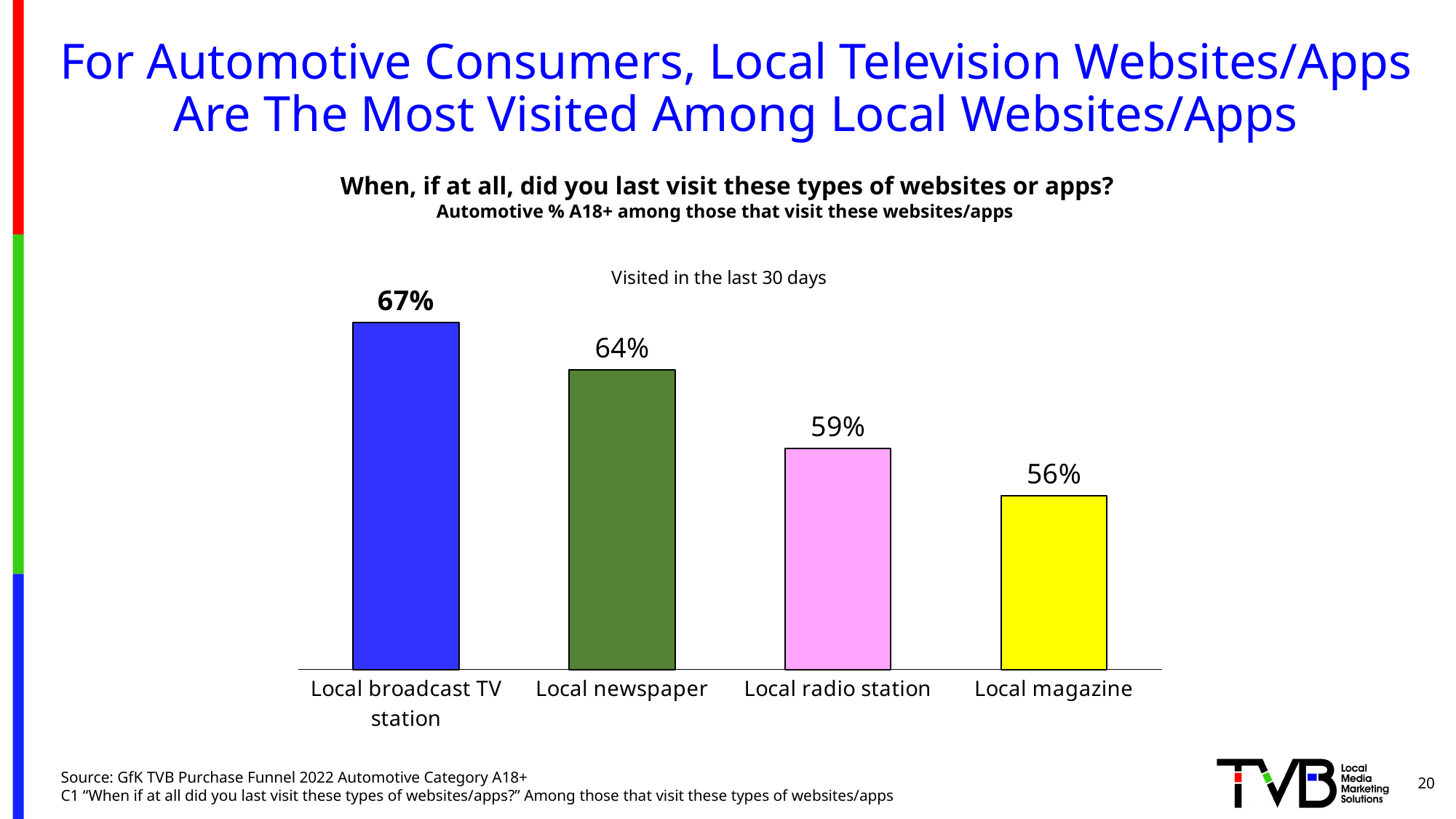
What is the value for Local radio station? 59% What kind of chart is shown on the slide? Bar chart What is the value for Local broadcast TV station? 67% What is the value for Local newspaper? 64% What is the value for Local magazine? 56% Which category has the highest value? Local broadcast TV station How many categories are shown in the chart? 4 Which is larger, the value for Local newspaper or the value for Local radio station? Local newspaper Which category has the lowest value? Local magazine What is the title of the chart? Visited in the last 30 days What is the difference between the values for Local broadcast TV station and Local magazine? 11% What is the difference between the values for Local newspaper and Local radio station? 5%